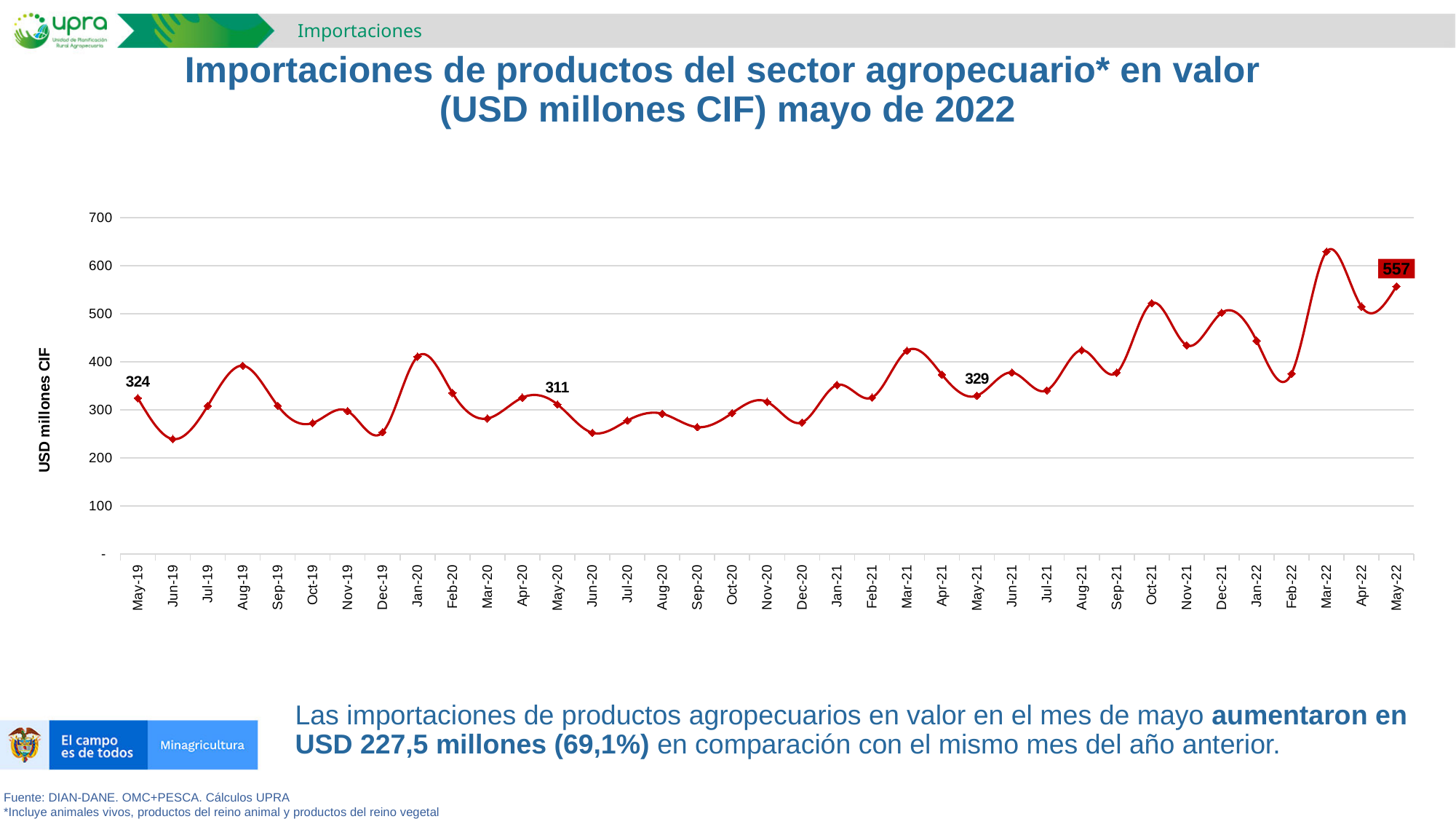
Is the value for Jun-19 greater or less than 300? less What is the value for May-22? 557 What kind of chart is shown on the slide? line chart Which is larger, the value for May-21 or the value for May-20? May-21 What is the difference between the values for May-22 and May-21? 228 Which month has the highest value on the chart? Mar-22 How many monthly data points are plotted on the chart? 37 Which month has the lowest value on the chart? Jun-19 What is the value for May-20? 311 What is the value for May-21? 329 Is the value for Mar-22 greater or less than 600? greater What is the value for May-19? 324